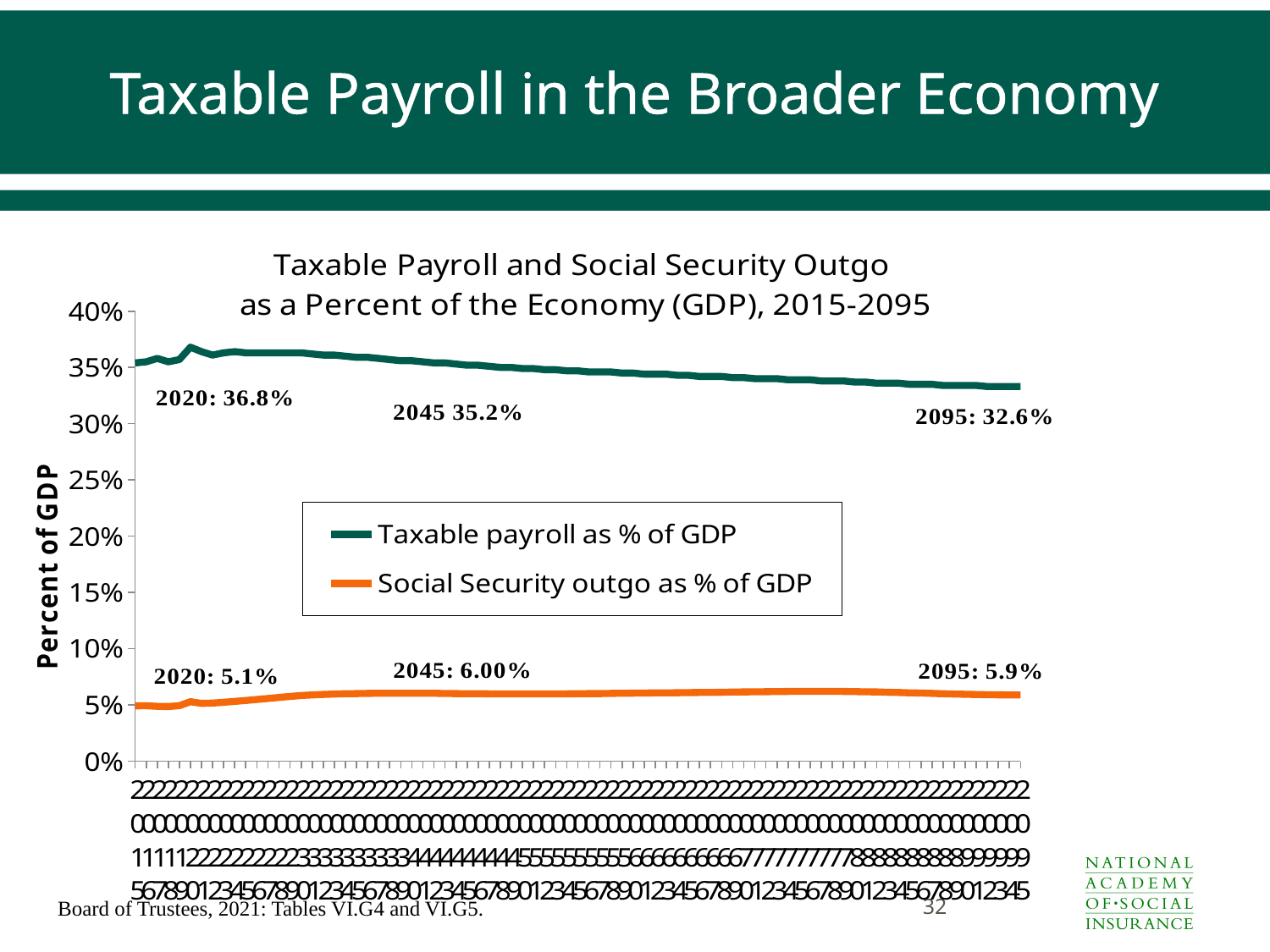
What kind of chart is shown on the slide? line chart Is the value of taxable payroll as % of GDP in 2095 greater or less than 35%? less How many series does the legend list? 2 What is the value of Social Security outgo as % of GDP in 2045? 6.00% What is the title of the chart? Taxable Payroll and Social Security Outgo as a Percent of the Economy (GDP), 2015-2095 What is the value of Social Security outgo as % of GDP in 2020? 5.1% What is the value of taxable payroll as % of GDP in 2020? 36.8% What is the value of taxable payroll as % of GDP in 2045? 35.2% Does the taxable payroll as % of GDP line rise or fall from 2045 to 2095? fall What is the value of taxable payroll as % of GDP in 2095? 32.6% Which is larger in 2095: taxable payroll as % of GDP or Social Security outgo as % of GDP? Taxable payroll as % of GDP By how many percentage points does taxable payroll as % of GDP fall from 2020 to 2095? 4.2